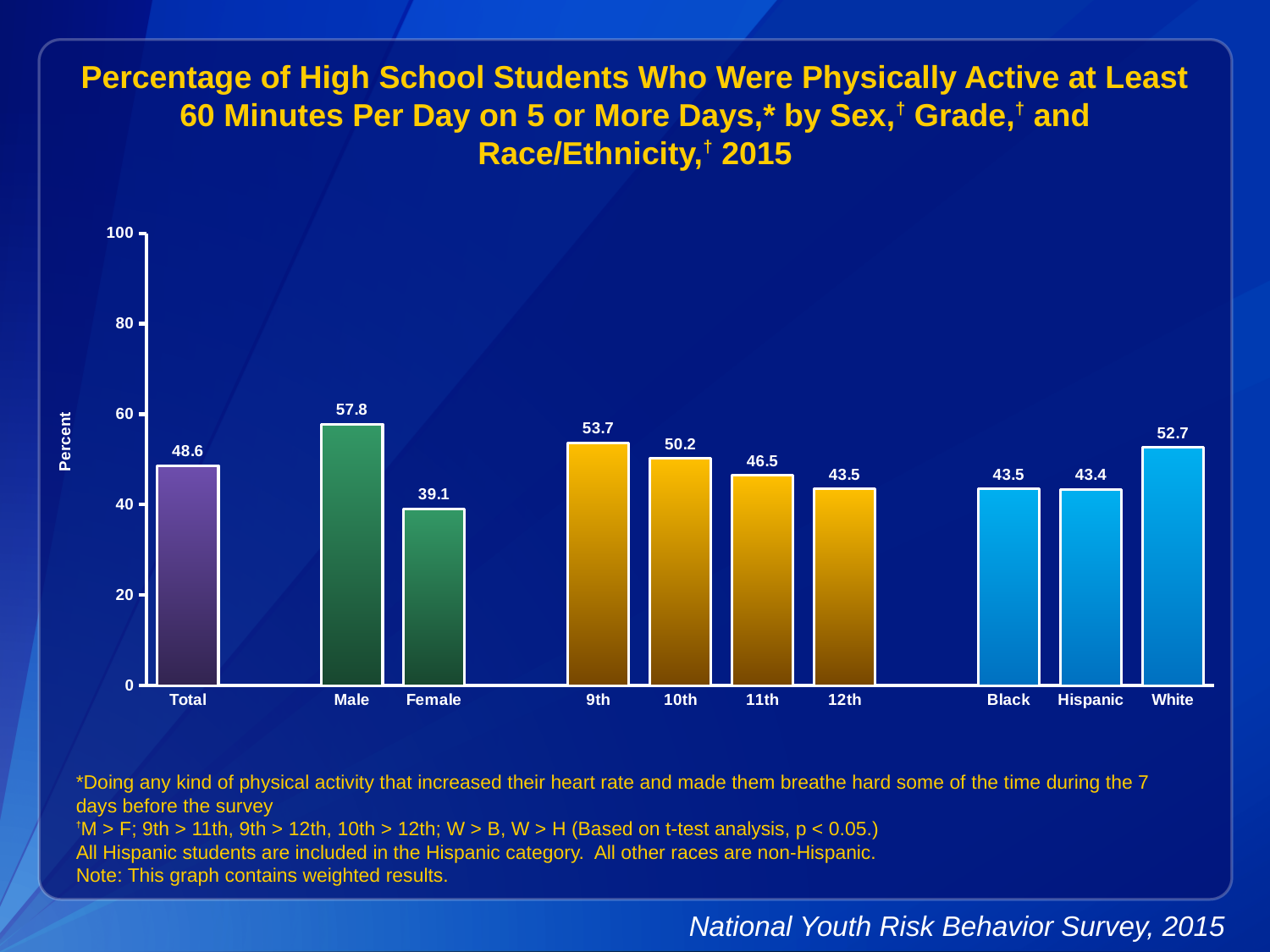
What is the value for Female? 39.1 What is the value for Male? 57.8 Is the value for White greater or less than 40? greater What is the value for Total? 48.6 What is the label of the y axis? Percent Which category has the highest value? Male How many bars are shown in the chart? 10 What is the value for 10th grade? 50.2 What is the difference between the Male and Female values? 18.7 Which category has the lowest value? Female What kind of chart is shown on the slide? Bar chart Which is larger, the value for 9th grade or the value for 12th grade? 9th